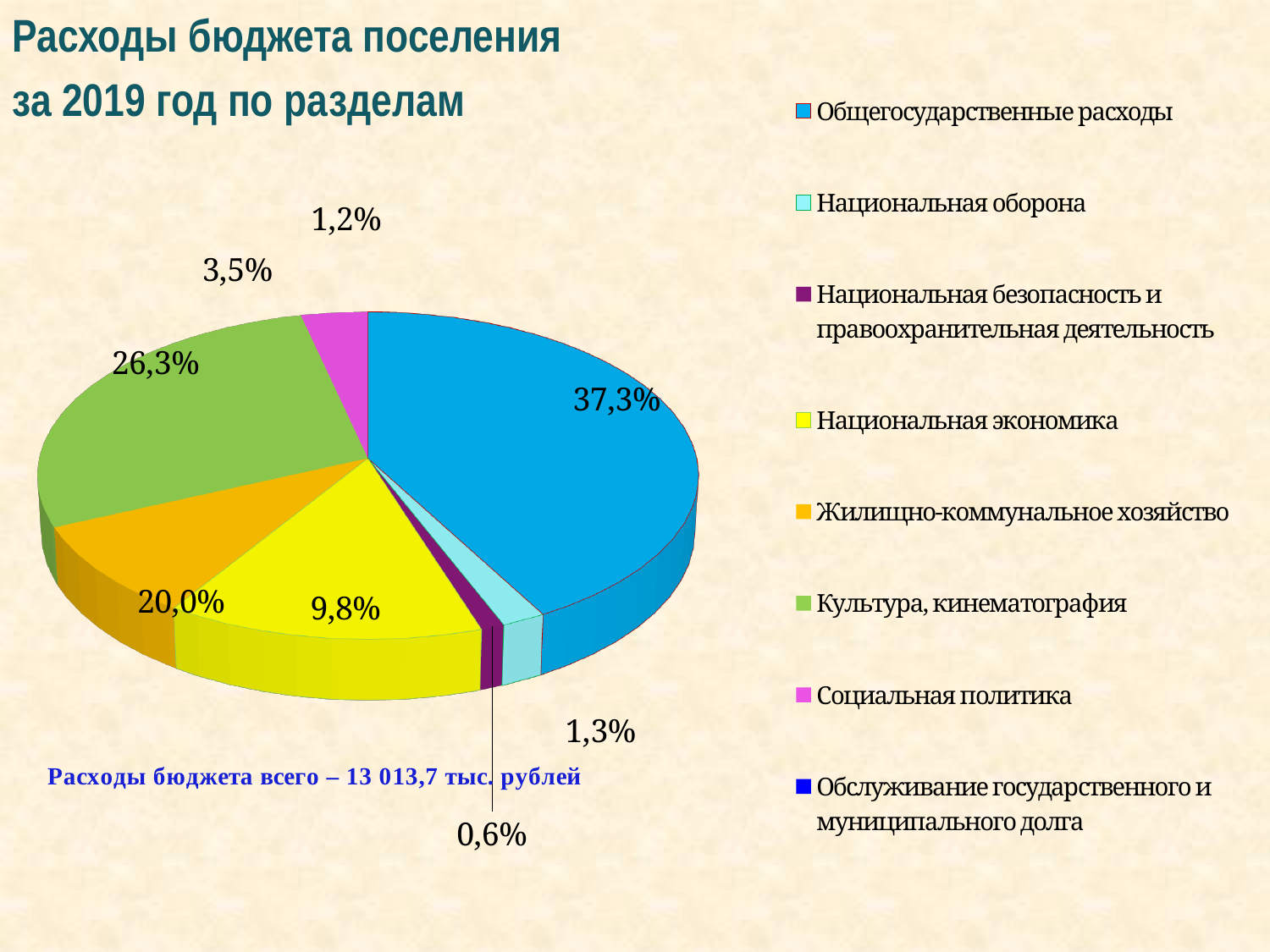
What share of the budget expenses goes to Национальная оборона? 1,3% How many sections does the legend list? 8 What share of the budget expenses goes to Национальная экономика? 9,8% What share of the budget expenses goes to Общегосударственные расходы? 37,3% Which section has the largest share of the budget expenses? Общегосударственные расходы Which is larger: the share for Культура, кинематография or the share for Жилищно-коммунальное хозяйство? Культура, кинематография What type of chart is shown on the slide? pie chart What is the difference in percentage points between the share for Общегосударственные расходы and the share for Культура, кинематография? 11,0